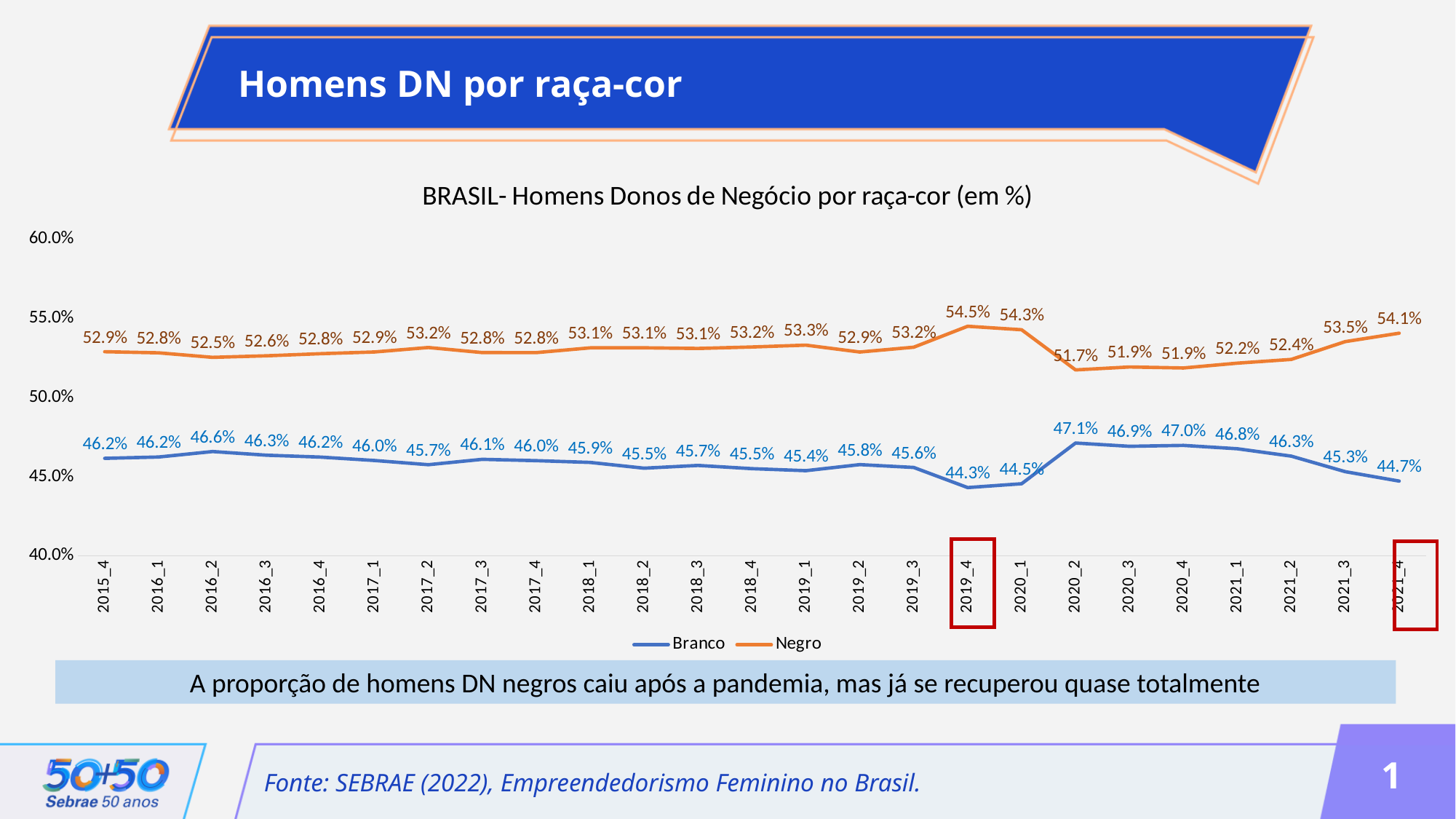
What is the value for Branco in 2020_2? 47.1% Which series has the higher value in 2020_1, Branco or Negro? Negro Is the value for Negro in 2020_2 greater or less than 55.0%? less What kind of chart is shown on the slide? Line chart What is the value for Branco in 2021_4? 44.7% In which period does the Negro series reach its lowest value? 2020_2 How many time periods are plotted on the x axis? 25 How many series does the legend list? 2 In which period does the Branco series reach its lowest value? 2019_4 What is the value for Negro in 2019_4? 54.5% What is the difference between the Negro and Branco values in 2021_4? 9.4 percentage points In which period does the Branco series reach its highest value? 2020_2